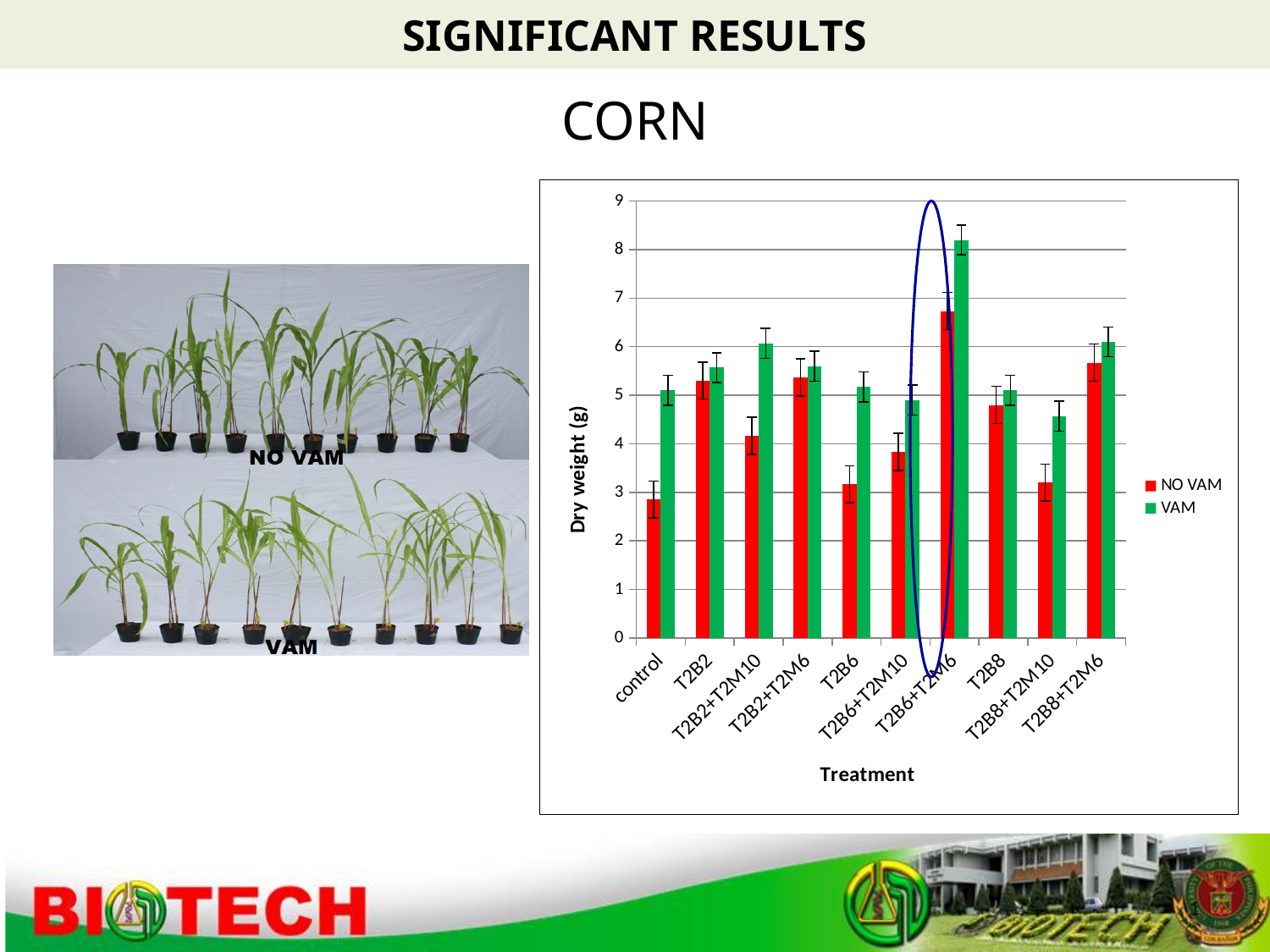
For the control treatment, which is larger: the NO VAM or the VAM dry weight? VAM Which treatment has the highest NO VAM dry weight? T2B6+T2M6 How many treatment categories are shown on the x axis of the chart? 10 Is the VAM dry weight for T2B6+T2M6 greater or less than 8? greater What is the label of the chart's y axis? Dry weight (g) Which has the larger NO VAM dry weight: T2B6+T2M6 or T2B8? T2B6+T2M6 Is the NO VAM dry weight for control greater or less than 3? less What kind of chart is shown on the slide? bar chart Which treatment has the highest VAM dry weight? T2B6+T2M6 Is the NO VAM dry weight for T2B6 greater or less than 4? less How many series does the chart legend list? 2